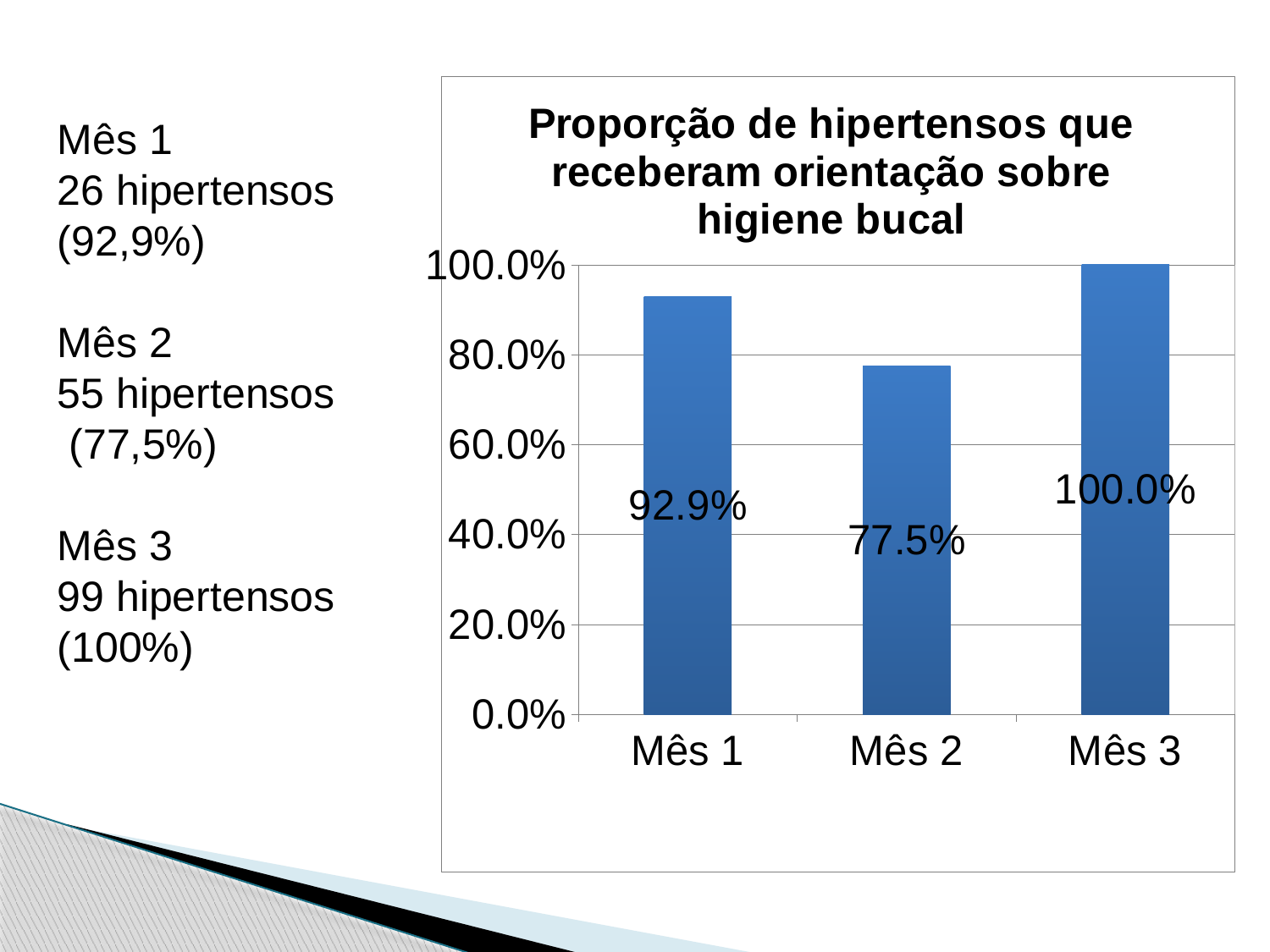
What kind of chart is shown on the slide? bar chart Is the value for Mês 2 greater or less than 80.0%? less Which month has the highest value? Mês 3 What is the value for Mês 2? 77.5% What is the value for Mês 1? 92.9% What is the title of the chart? Proporção de hipertensos que receberam orientação sobre higiene bucal Which is larger, the value for Mês 1 or the value for Mês 2? Mês 1 Which month has the lowest value? Mês 2 What is the value for Mês 3? 100.0% What is the difference between the values for Mês 3 and Mês 2? 22.5% How many months are shown on the x axis? 3 What is the difference between the values for Mês 1 and Mês 2? 15.4%